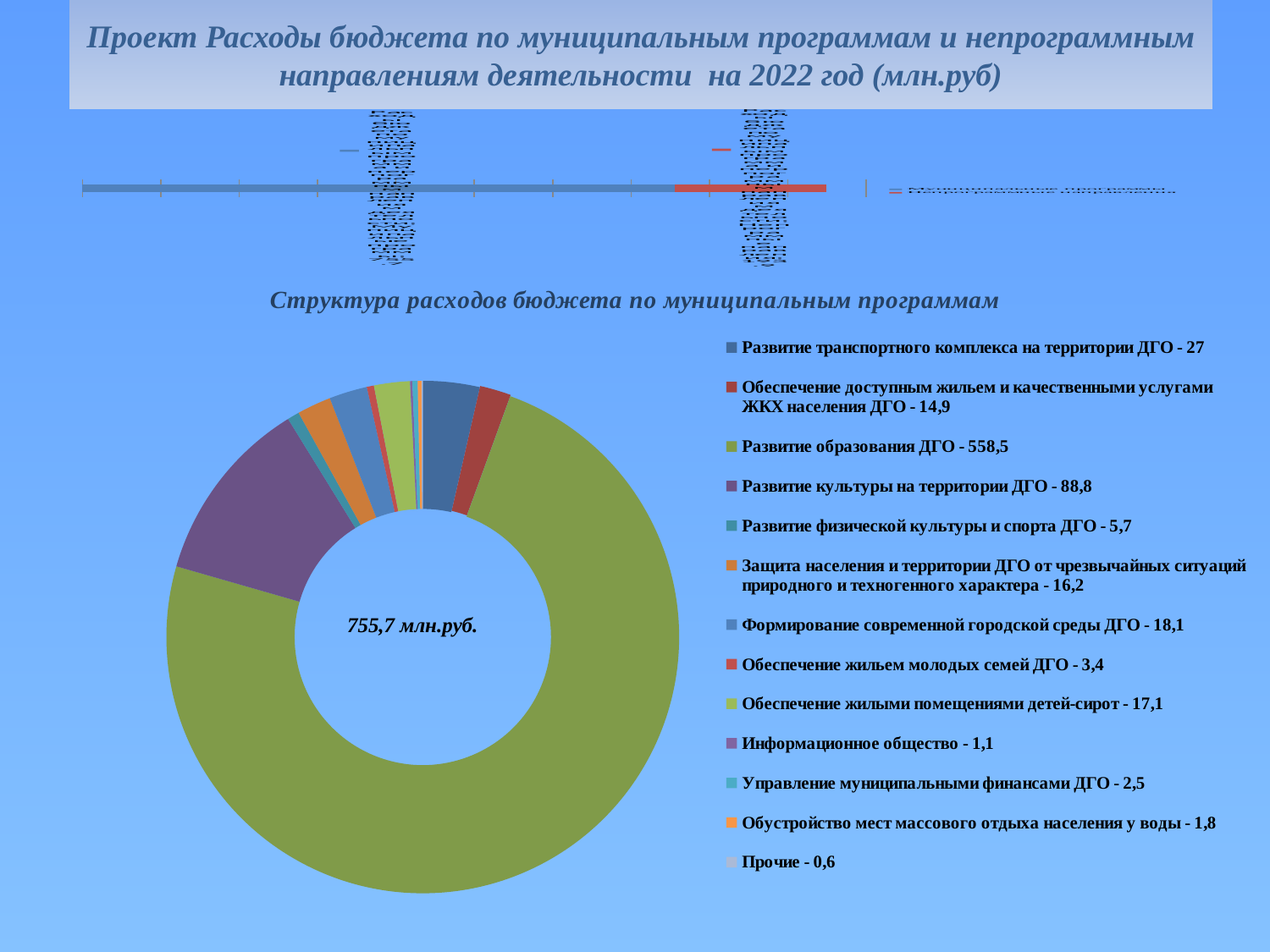
In the chart 'Структура расходов бюджета по муниципальным программам', how many categories are listed in the legend? 13 In the chart 'Структура расходов бюджета по муниципальным программам', what is the value for 'Развитие культуры на территории ДГО'? 88,8 In the chart 'Структура расходов бюджета по муниципальным программам', what is the value for 'Управление муниципальными финансами ДГО'? 2,5 In the chart 'Структура расходов бюджета по муниципальным программам', which is larger: 'Формирование современной городской среды ДГО' or 'Обеспечение жилыми помещениями детей-сирот'? Формирование современной городской среды ДГО In the chart titled 'Структура расходов бюджета по муниципальным программам', what kind of chart is shown? pie chart (donut) In the chart 'Структура расходов бюджета по муниципальным программам', what is the difference between 'Развитие транспортного комплекса на территории ДГО' (27) and 'Обеспечение доступным жильем и качественными услугами ЖКХ населения ДГО' (14,9)? 12,1 What is the title of the donut chart on the slide? Структура расходов бюджета по муниципальным программам In the chart 'Структура расходов бюджета по муниципальным программам', which category has the largest value? Развитие образования ДГО In the chart 'Структура расходов бюджета по муниципальным программам', what is the value for 'Развитие транспортного комплекса на территории ДГО'? 27 In the chart 'Структура расходов бюджета по муниципальным программам', what is the value for 'Развитие образования ДГО'? 558,5 In the chart 'Структура расходов бюджета по муниципальным программам', what total value is printed in the centre of the donut? 755,7 млн.руб. In the chart 'Структура расходов бюджета по муниципальным программам', which category has the smallest value? Прочие